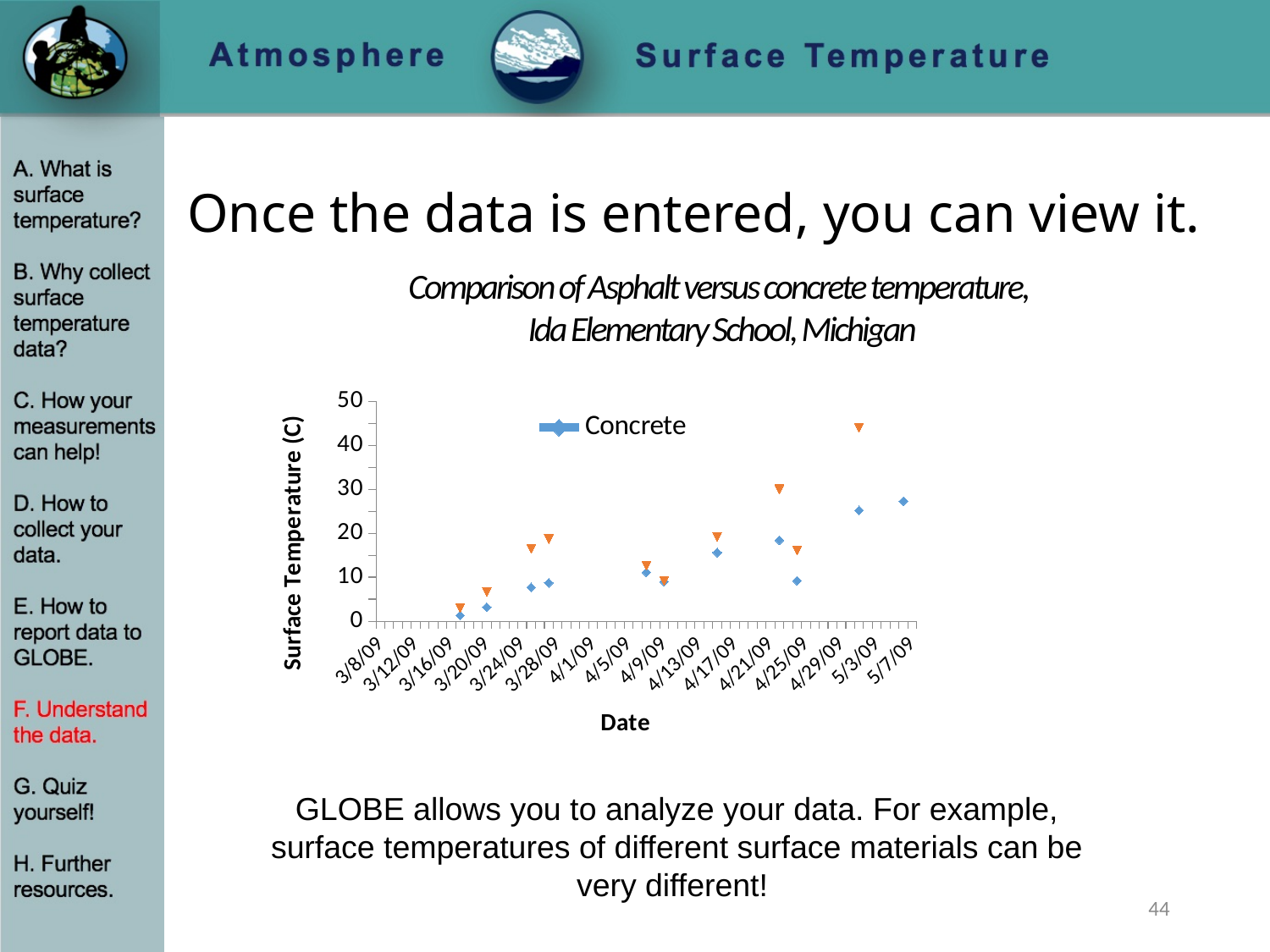
Do the Concrete values generally rise or fall from March to May along the x axis? rise What is the highest value shown on the y-axis? 50 Around 5/3/09, which is larger: the orange triangle value or the Concrete value? the orange triangle value What is the y-axis title of the chart? Surface Temperature (C) How many series does the chart legend list? 1 Is the highest orange triangle point (around 5/3/09) greater or less than 40? greater What is the label of the series listed in the legend? Concrete What is the title of the chart? Comparison of Asphalt versus concrete temperature, Ida Elementary School, Michigan What kind of chart is shown on the slide? scatter chart Is the Concrete value at the last date (5/7/09) greater or less than 20? greater Is the Concrete value around 4/13/09 greater or less than 20? less